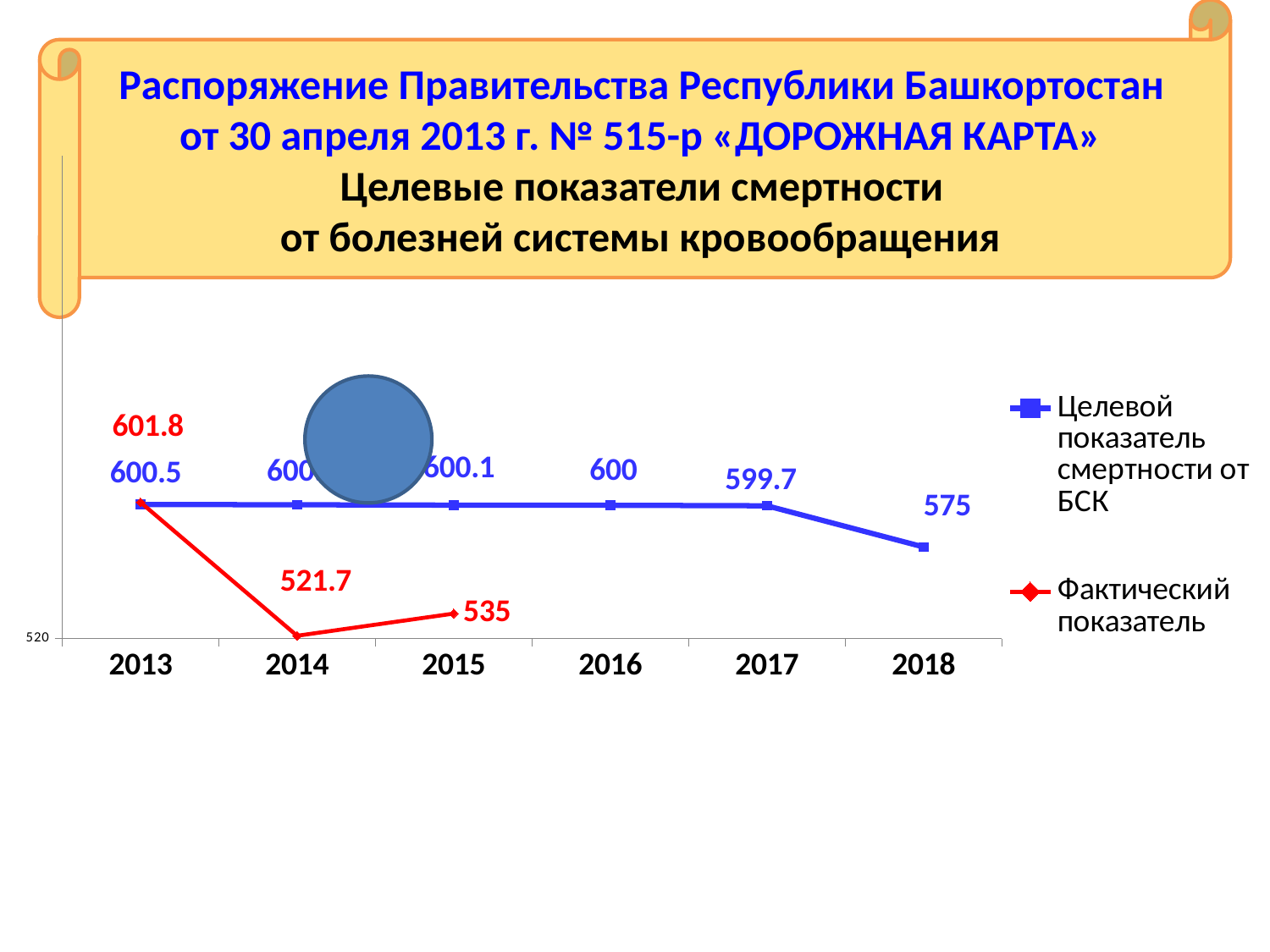
In which year is the target indicator lowest? 2018 What is the actual indicator for 2013? 601.8 What is the difference between the target indicator in 2013 and in 2018? 25.5 What is the target mortality indicator (Целевой показатель смертности от БСК) for 2013? 600.5 In 2013, which is larger: the target indicator or the actual indicator? Actual indicator (601.8) How many series does the legend list? 2 What is the target mortality indicator for 2017? 599.7 What is the actual indicator (Фактический показатель) for 2014? 521.7 What kind of chart is shown on the slide? Line chart What is the actual indicator for 2015? 535 By how much did the actual indicator change from 2014 to 2015? 13.3 What is the target mortality indicator for 2018? 575